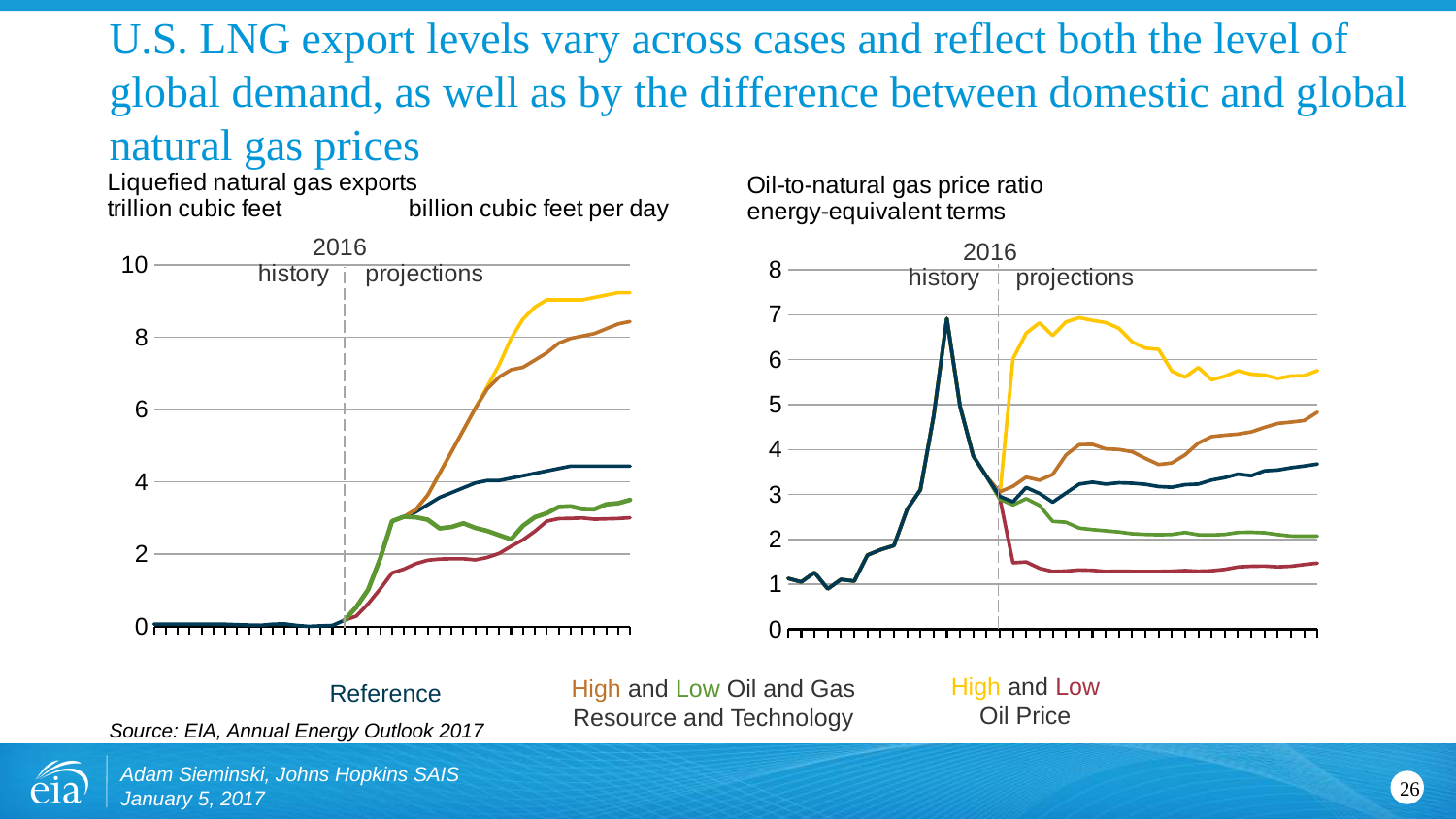
What kind of chart is the 'Liquefied natural gas exports' chart on the left? line chart In the 'Oil-to-natural gas price ratio' chart, is the Low Oil Price value at the end of the projections greater or less than 2? less In the 'Oil-to-natural gas price ratio' chart, which series is highest at the end of the projection period? High Oil Price In the 'Liquefied natural gas exports' chart, which series is highest at the end of the projection period? High Oil Price In the 'Liquefied natural gas exports' chart, is the High Oil Price value at the end of the projections greater or less than 8 trillion cubic feet? greater In the 'Oil-to-natural gas price ratio' chart, is the peak value in the history period greater or less than 6? greater In the 'Oil-to-natural gas price ratio' chart, which series is lowest at the end of the projection period? Low Oil Price In the 'Liquefied natural gas exports' chart, which series is lowest at the end of the projection period? Low Oil Price How many series does the legend at the bottom of the slide list? 5 In the 'Liquefied natural gas exports' chart, does the Reference series rise or fall over the projection period? rise What year does the dashed vertical line separating history from projections mark in both charts? 2016